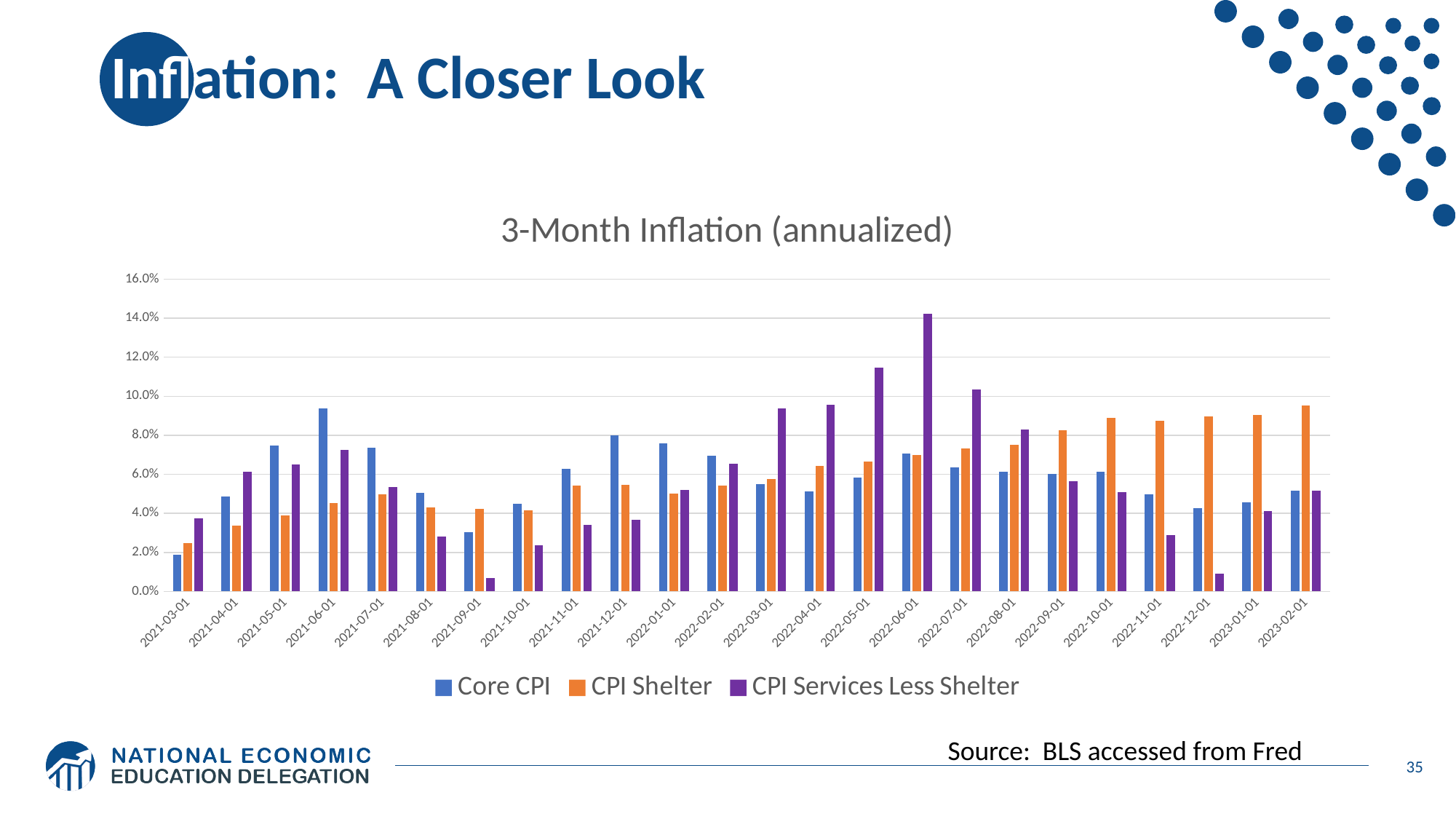
What type of chart is shown on the slide? Bar chart What is the title of the chart? 3-Month Inflation (annualized) How many series does the legend list? 3 In which month is the Core CPI value highest? 2021-06-01 Is the CPI Shelter value for 2021-03-01 greater or less than 4.0%? less Does the CPI Shelter series generally rise or fall from 2021-03-01 to 2023-02-01? Rise Is the CPI Services Less Shelter value for 2022-06-01 greater or less than 12.0%? greater Which series is shown in purple? CPI Services Less Shelter In which month is the Core CPI value lowest? 2021-03-01 For 2023-02-01, which is larger: Core CPI or CPI Shelter? CPI Shelter How many months (categories) are shown on the x axis? 24 In which month is the CPI Services Less Shelter value highest? 2022-06-01